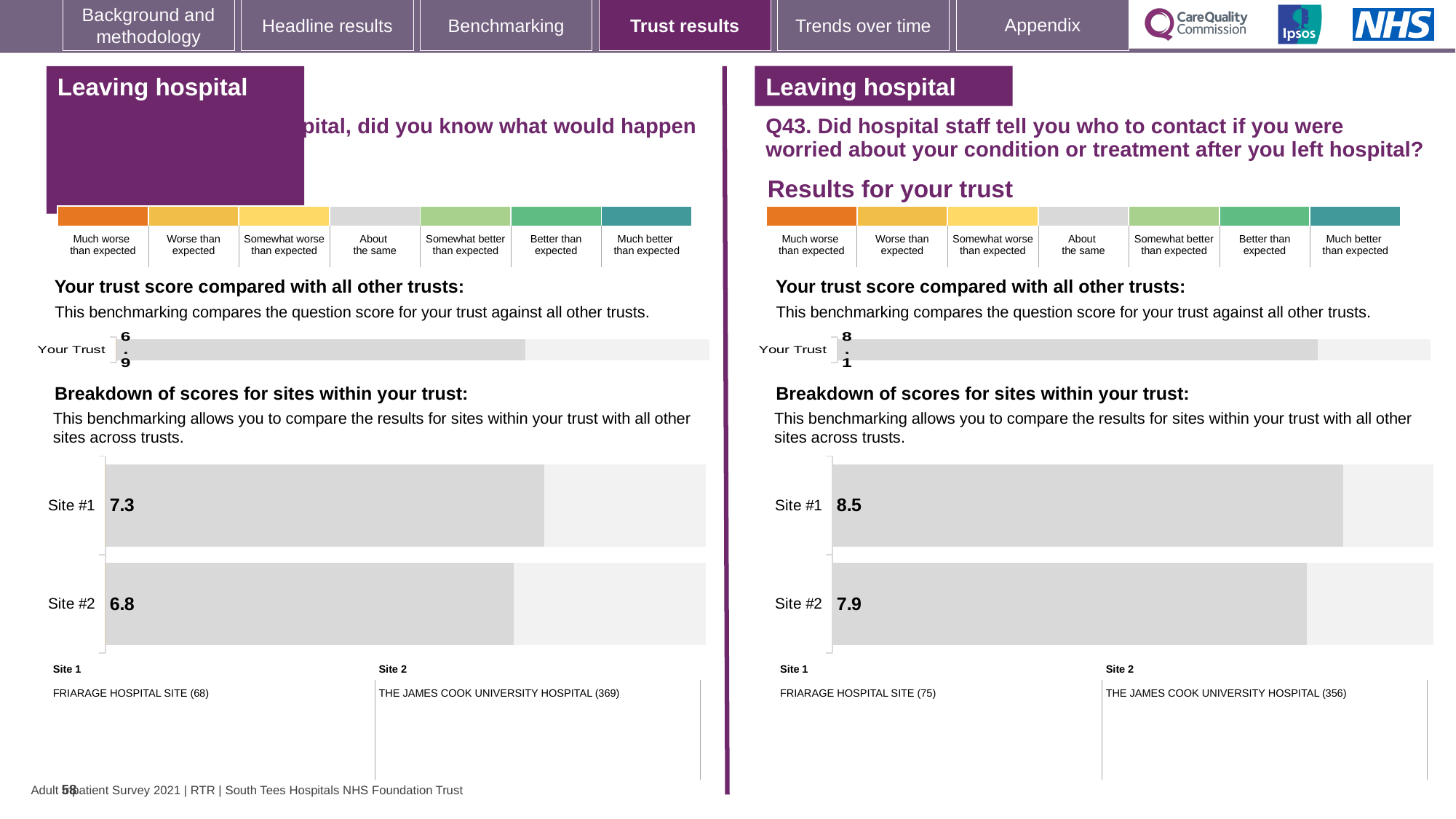
On the left half of the slide, what is the score shown for Site #1 in the breakdown of scores for sites within your trust? 7.3 How many sites are shown in the Q43 site breakdown chart on the right half of the slide? 2 What type of chart is used for the site breakdown on the left half of the slide? Bar chart On the left half of the slide, what is the 'Your Trust' score in the trust score comparison chart? 6.9 In the Q43 site breakdown chart on the right half of the slide, which site has the higher score? Site #1 In the Q43 site breakdown chart on the right half of the slide, what is the score for Site #1? 8.5 In the Q43 trust score comparison chart on the right half of the slide, what is the 'Your Trust' score? 8.1 In the Q43 site breakdown chart on the right half of the slide, what is the difference between the Site #1 and Site #2 scores? 0.6 In the site breakdown chart on the left half of the slide, what is the difference between the Site #1 and Site #2 scores? 0.5 On the left half of the slide, what is the score shown for Site #2 in the breakdown of scores for sites within your trust? 6.8 In the Q43 site breakdown chart on the right half of the slide, what is the score for Site #2? 7.9 In the site breakdown chart on the left half of the slide, which site has the lower score? Site #2